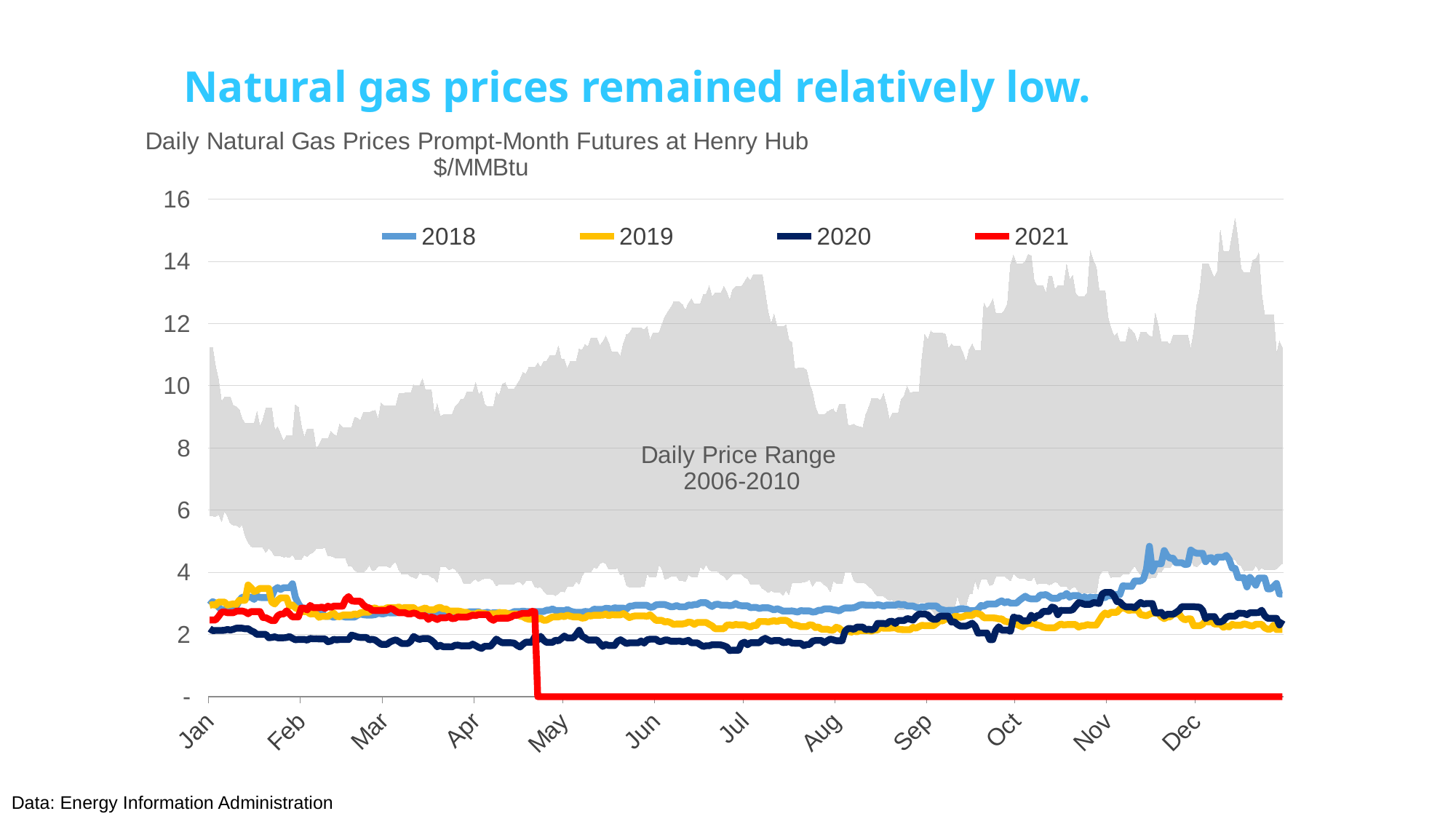
How many series does the legend list? 4 What kind of chart is shown on the slide? line chart Is the value for 2020 in June greater or less than 2? less What does the grey shaded area in the chart represent? Daily Price Range 2006-2010 Does the 2018 line rise or fall from October to November? rise How many month labels are shown along the x axis? 12 Is the top of the grey Daily Price Range at the start of January greater or less than 10? greater In June, which line is higher, 2018 or 2020? 2018 Is the value for 2019 in July greater or less than 4? less What unit is given for the prices in the chart subtitle? $/MMBtu Which year's line reaches the highest value on the chart? 2018